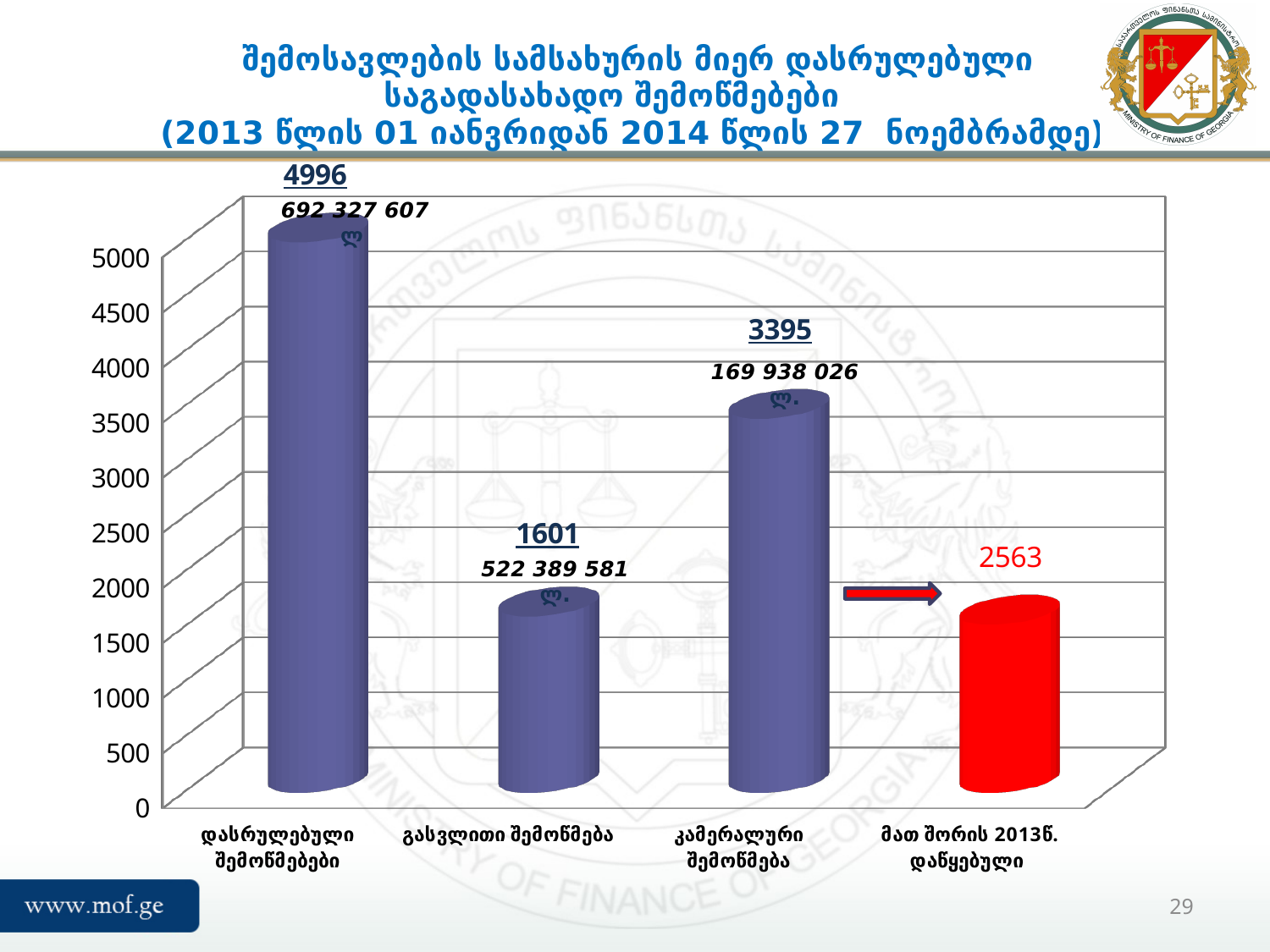
What is the value shown for the bar labelled "დასრულებული შემოწმებები"? 4996 What amount in lari is printed above the bar for "გასვლითი შემოწმება"? 522 389 581 What is the value shown for the red bar labelled "მათ შორის 2013წ. დაწყებული"? 2563 What is the value shown for the bar labelled "კამერალური შემოწმება"? 3395 Which category has the highest bar? დასრულებული შემოწმებები Which is larger, the value for "კამერალური შემოწმება" or the value for "მათ შორის 2013წ. დაწყებული"? კამერალური შემოწმება What is the difference between the values for "დასრულებული შემოწმებები" and "კამერალური შემოწმება"? 1601 What kind of chart is shown on the slide? bar chart What is the difference between the values for "კამერალური შემოწმება" and "გასვლითი შემოწმება"? 1794 How many bars are shown in the chart? 4 What is the value shown for the bar labelled "გასვლითი შემოწმება"? 1601